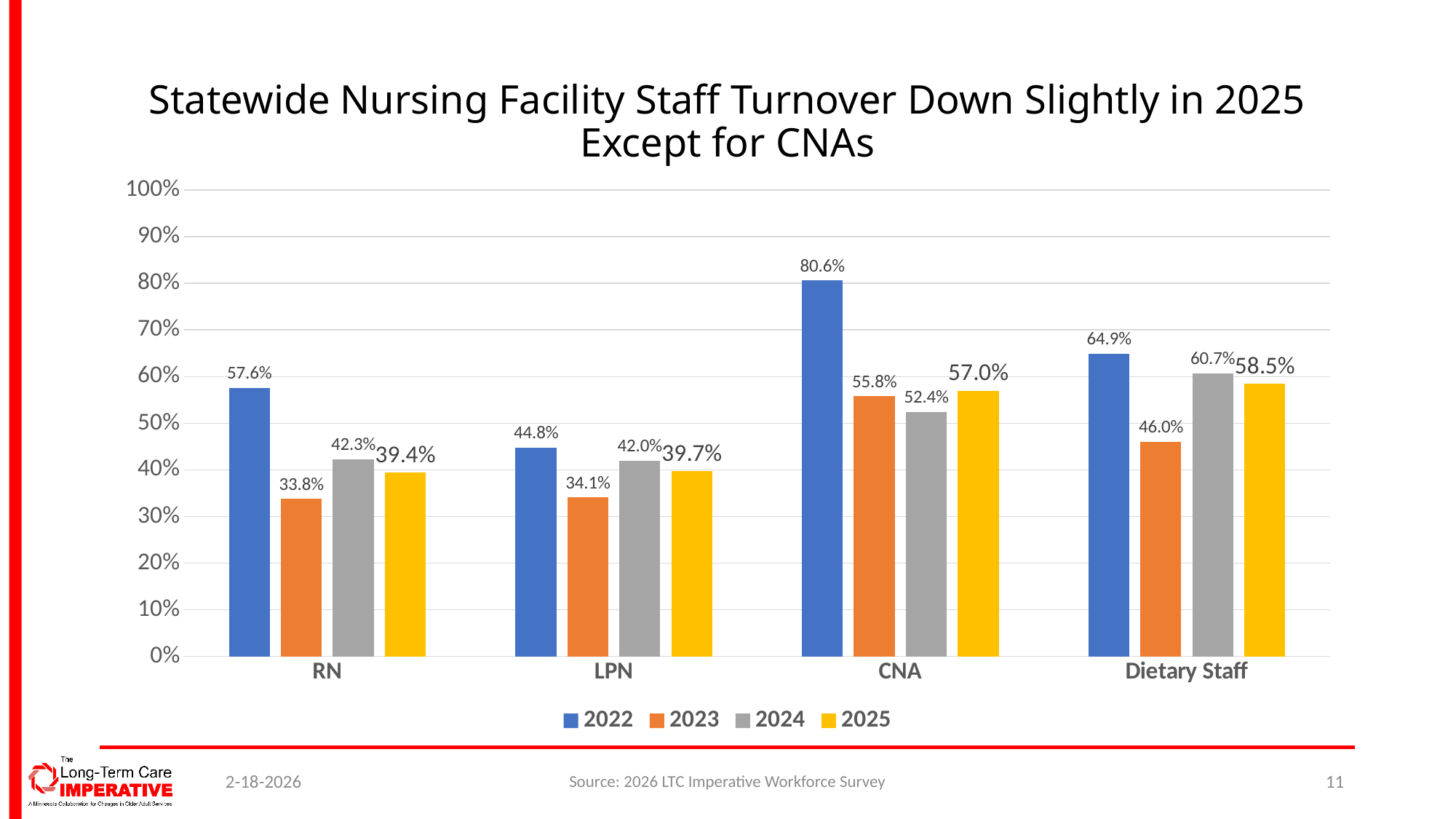
What is the difference between the 2022 and 2025 turnover values for CNA? 23.6% What is the 2024 turnover value for LPN? 42.0% What is the 2022 turnover value for RN? 57.6% Which category has the lowest 2023 turnover value? RN Which colour represents the 2025 series in the legend? Yellow How many series does the legend list? 4 What kind of chart is shown on the slide? Bar chart What is the 2023 turnover value for Dietary Staff? 46.0% Which category has the highest 2022 turnover value? CNA Which is larger, the 2024 turnover value for CNA or the 2025 turnover value for CNA? 2025 What is the 2025 turnover value for CNA? 57.0% How many staff categories are shown on the x axis? 4